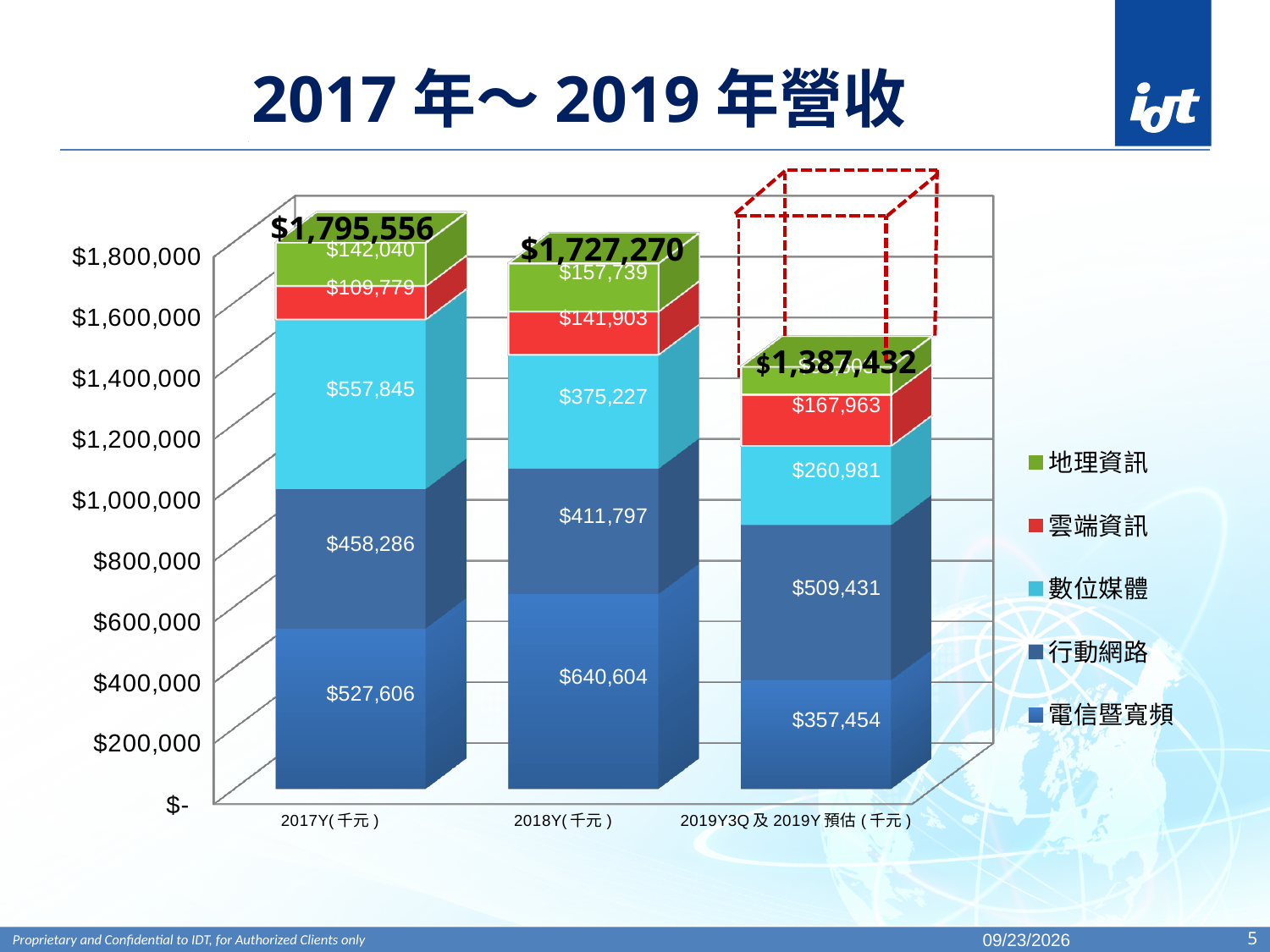
Which year has the highest total revenue? 2017Y(千元) What is the total of the stacked bar for 2018Y(千元)? $1,727,270 How many series does the legend list? 5 What is the difference between the 電信暨寬頻 values for 2018Y(千元) and 2017Y(千元)? $112,998 What is the total of the stacked bar for 2019Y3Q及2019Y預估(千元)? $1,387,432 What kind of chart is shown on the slide? Stacked bar chart What is the value for 行動網路 in 2019Y3Q及2019Y預估(千元)? $509,431 Do the total revenues rise or fall from 2017Y to 2019Y3Q及2019Y預估? Fall Which series has the lowest value in 2017Y(千元)? 雲端資訊 What is the value for 數位媒體 in 2018Y(千元)? $375,227 Which is larger, 數位媒體 in 2017Y(千元) or 數位媒體 in 2018Y(千元)? 2017Y(千元) What is the value for 電信暨寬頻 in 2017Y(千元)? $527,606